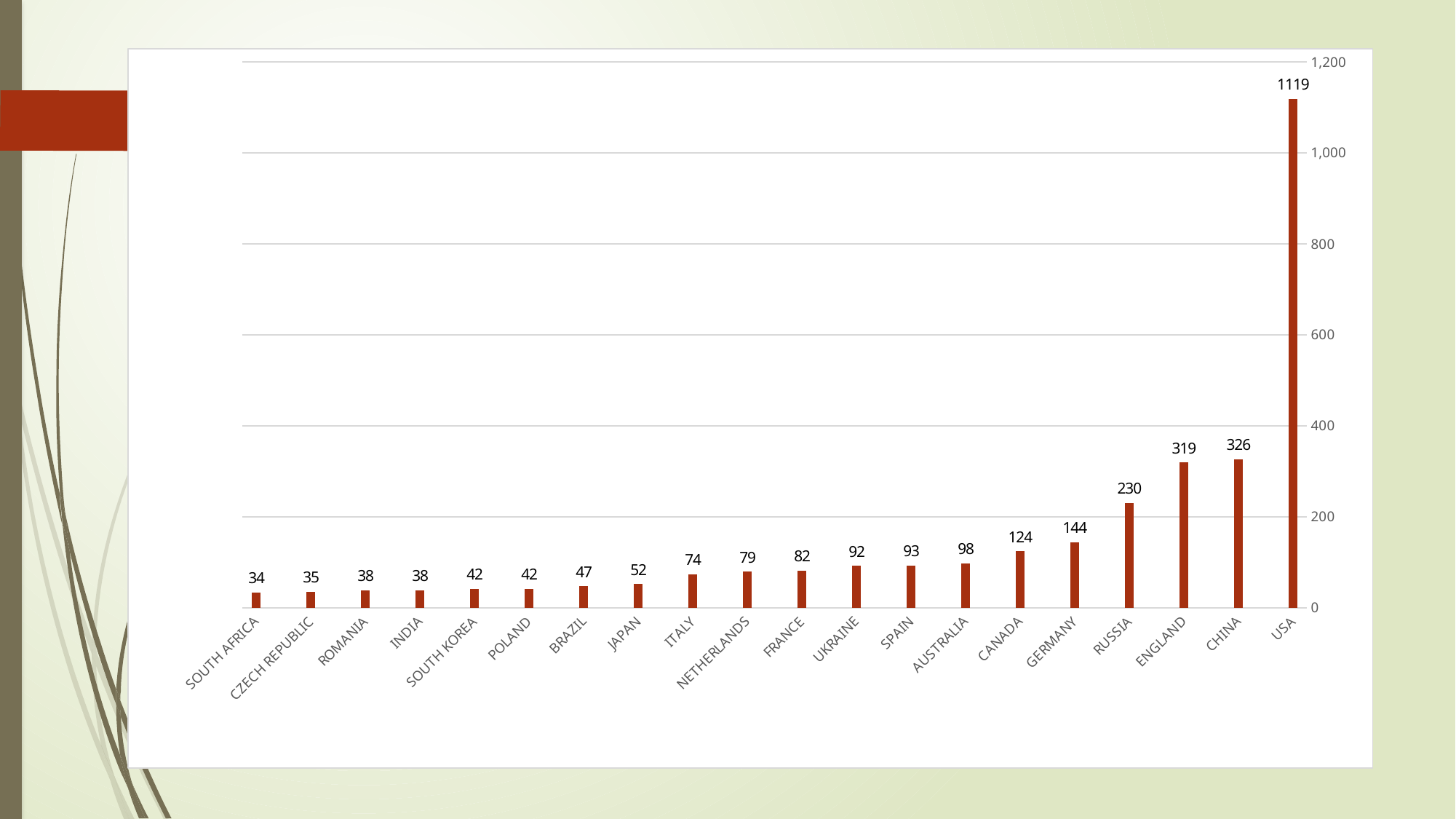
Do the values rise or fall from left to right along the x axis? Rise Which country has the highest value? USA What is the value for Germany? 144 What is the value for Japan? 52 What is the difference between the values for China and England? 7 Is the value for Russia greater or less than 200? greater How many countries are shown on the chart? 20 What is the difference between the values for USA and China? 793 What is the value for USA? 1119 Which country has the lowest value? South Africa What kind of chart is shown on the slide? Bar chart Which has a larger value, Russia or Canada? Russia